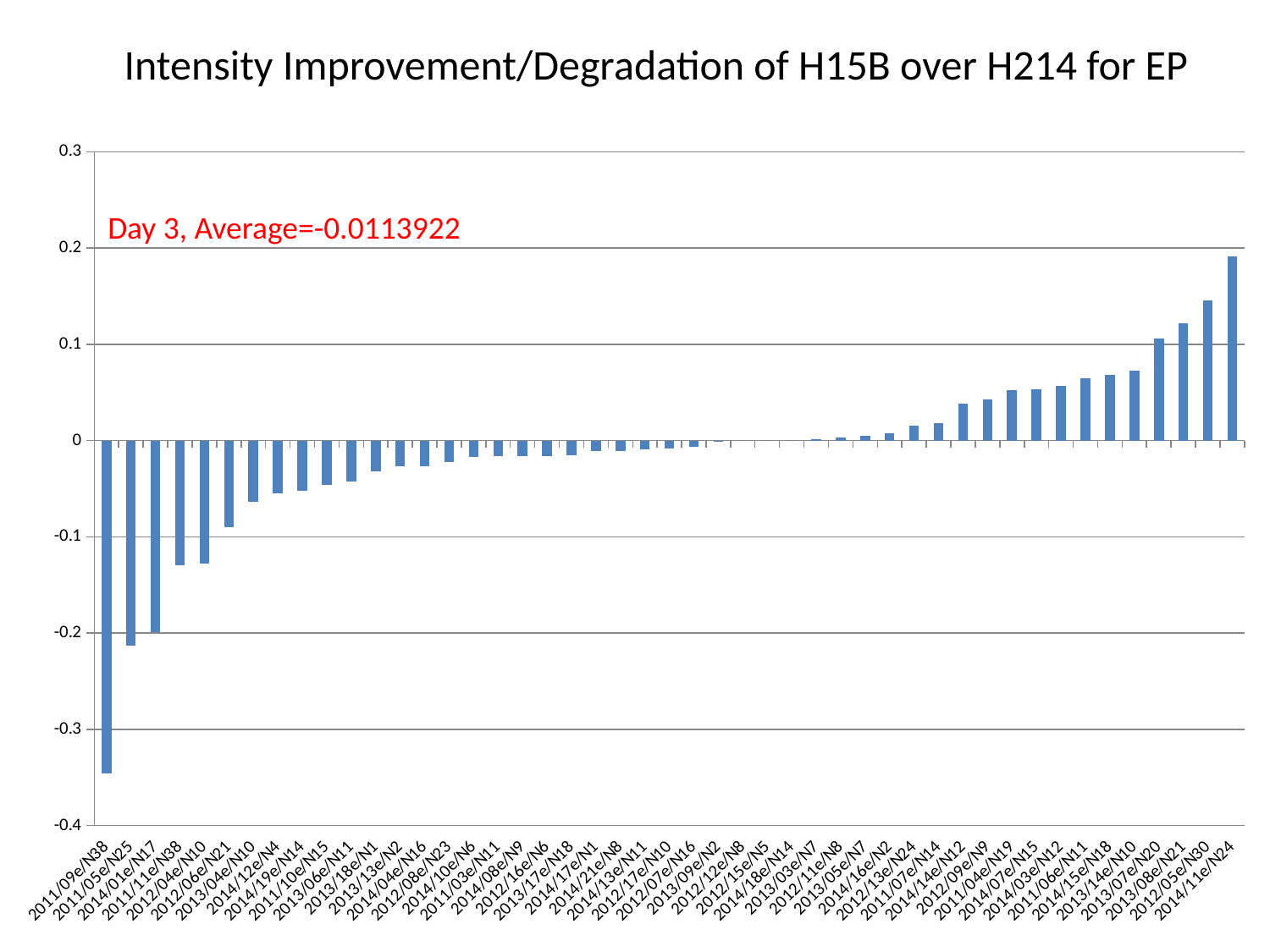
Which category has the highest value? 2014/11e/N24 Is the value for 2014/11e/N24 greater or less than 0.1? greater Which has the larger value, 2011/05e/N25 or 2012/04e/N10? 2012/04e/N10 Do the bar values rise or fall from left to right along the x axis? rise Is the value for 2011/11e/N38 greater or less than -0.1? less Which has the larger value, 2011/09e/N38 or 2014/11e/N24? 2014/11e/N24 What average value is annotated on the chart? -0.0113922 What type of chart is shown on the slide? bar chart Which category has the lowest value? 2011/09e/N38 What is the title of the chart? Intensity Improvement/Degradation of H15B over H214 for EP Is the value for 2012/05e/N30 greater or less than 0.1? greater